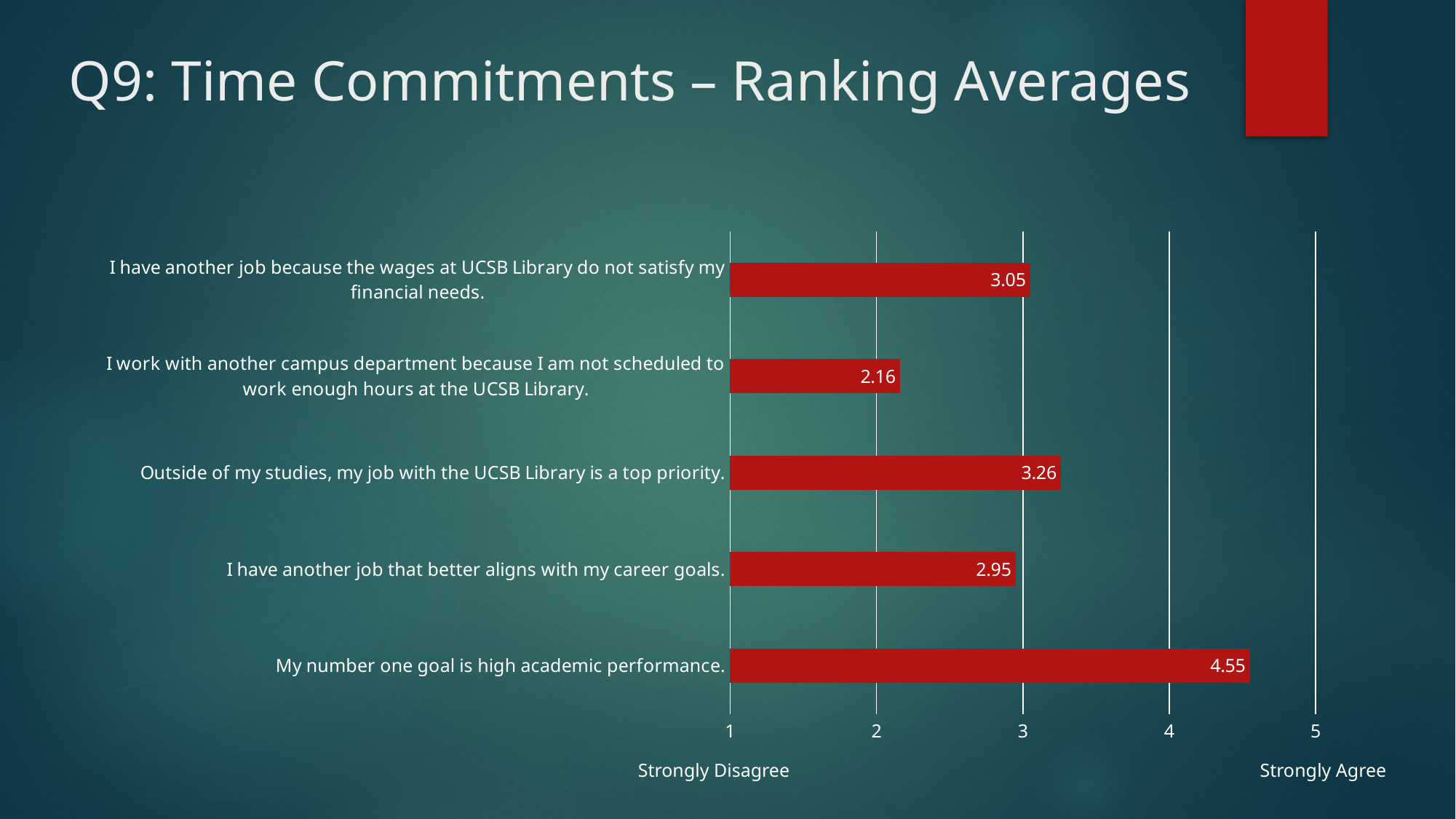
What type of chart is shown on the slide? Bar chart What is the ranking average for "I work with another campus department because I am not scheduled to work enough hours at the UCSB Library."? 2.16 What label appears at the right end of the x axis, under the value 5? Strongly Agree Is the ranking average for "Outside of my studies, my job with the UCSB Library is a top priority." greater or less than 3? greater What is the ranking average for "My number one goal is high academic performance."? 4.55 Which statement has the lowest ranking average? I work with another campus department because I am not scheduled to work enough hours at the UCSB Library. How many statements are shown in the chart? 5 What is the difference between the ranking averages for "My number one goal is high academic performance." and "I work with another campus department because I am not scheduled to work enough hours at the UCSB Library."? 2.39 What is the ranking average for "Outside of my studies, my job with the UCSB Library is a top priority."? 3.26 What is the ranking average for "I have another job that better aligns with my career goals."? 2.95 Which statement has the highest ranking average? My number one goal is high academic performance. Which has a higher ranking average: "I have another job because the wages at UCSB Library do not satisfy my financial needs." or "I have another job that better aligns with my career goals."? I have another job because the wages at UCSB Library do not satisfy my financial needs.